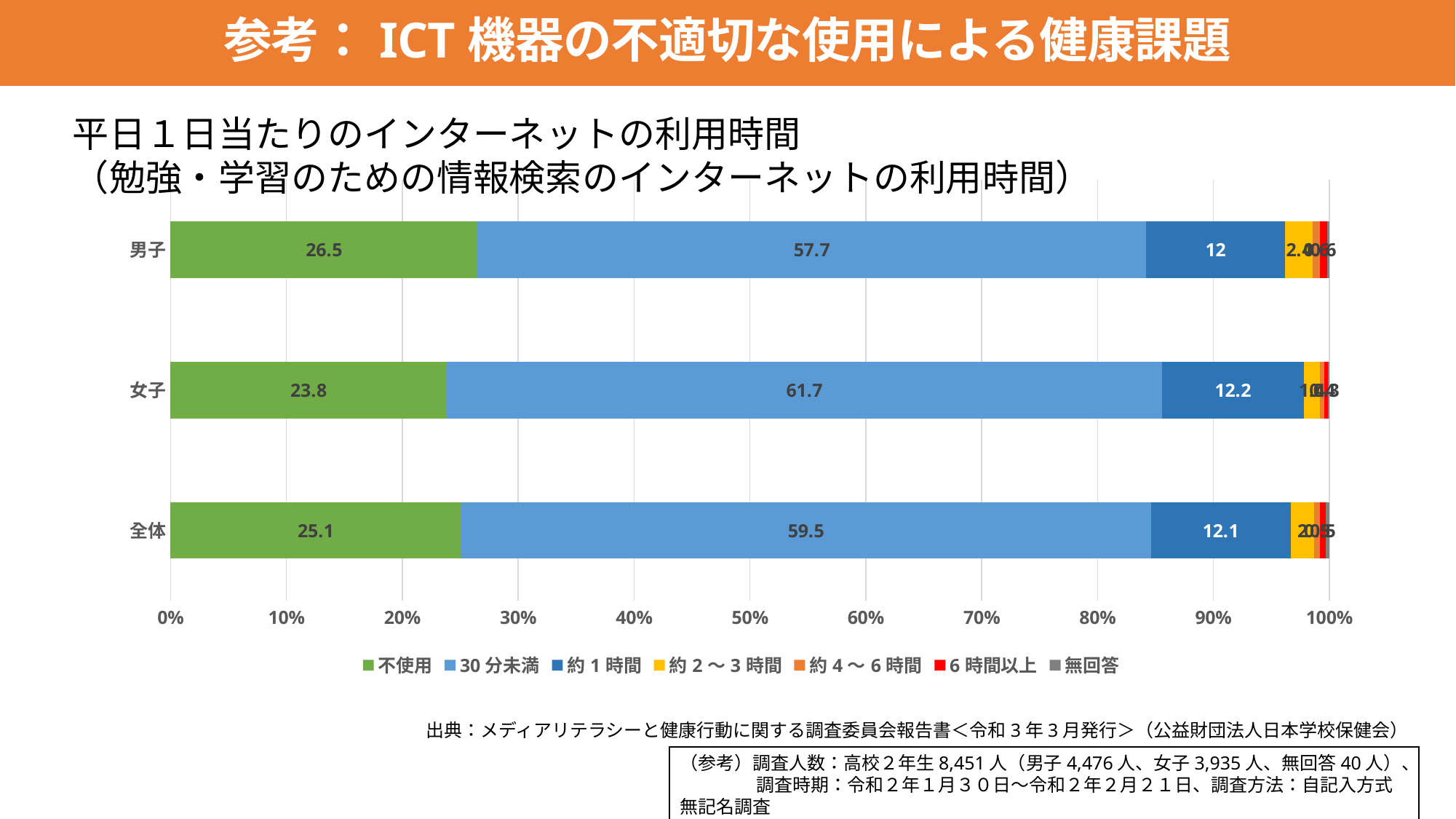
Which category has the lowest value for 不使用? 女子 How many series does the legend list? 7 Which is larger, the 約1時間 value for 男子 or for 女子? 女子 What is the value of 30分未満 for 男子? 57.7 What is the value of 30分未満 for 女子? 61.7 How many categories are shown on the vertical axis of the chart? 3 What is the value of 約1時間 for 全体? 12.1 What kind of chart is shown on the slide? Stacked bar chart What is the value of 不使用 for 男子? 26.5 What is the difference between the 30分未満 values for 女子 and 男子? 4 Which category has the highest value for 30分未満? 女子 What is the difference between the 不使用 values for 男子 and 女子? 2.7